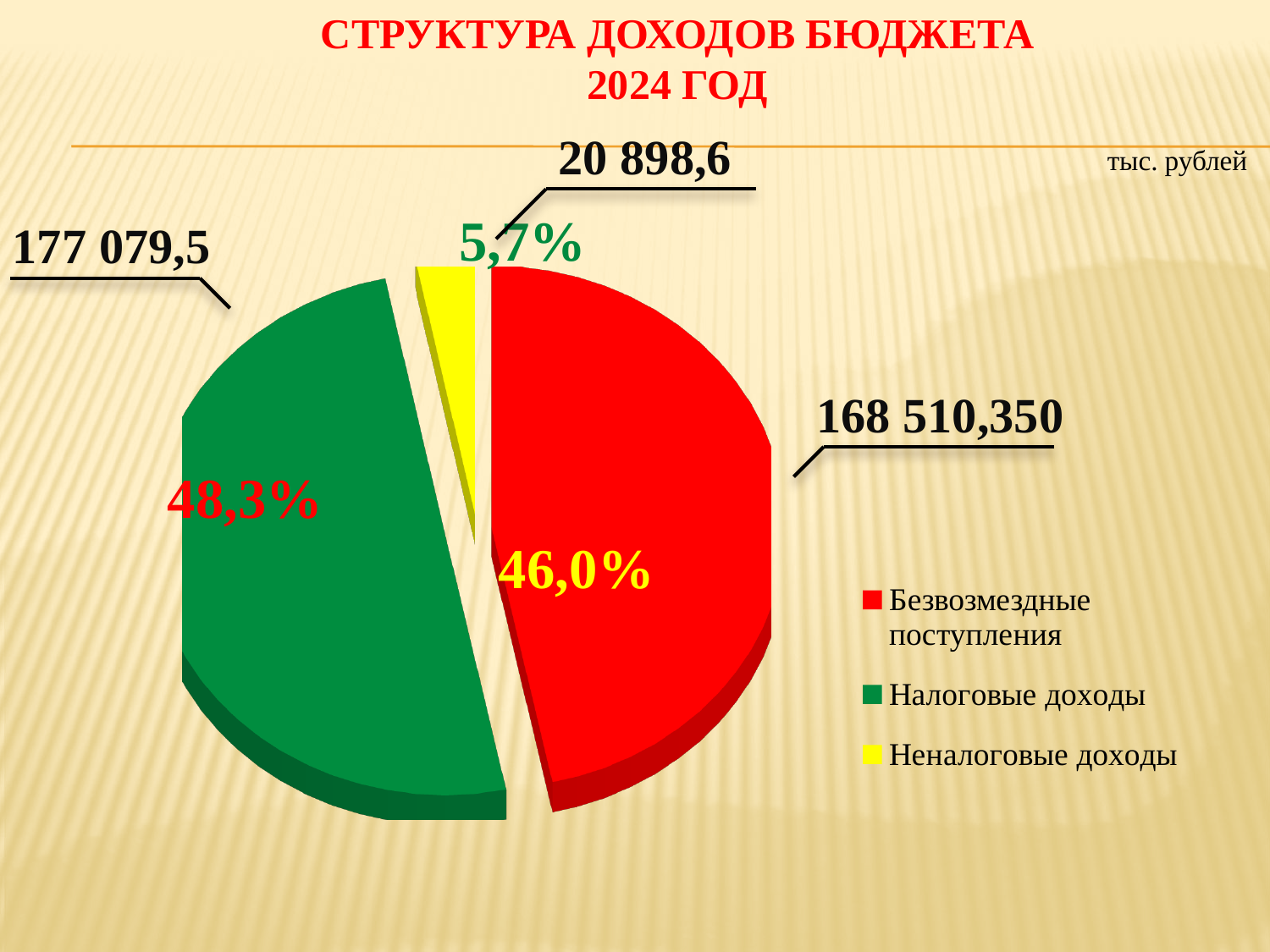
What percentage share does the Безвозмездные поступления slice have? 46,0% What type of chart is shown on the slide? Pie chart What is the value shown for Неналоговые доходы? 20 898,6 Which category has the largest share of the pie? Налоговые доходы Which is larger, the share of Налоговые доходы or the share of Неналоговые доходы? Налоговые доходы How many categories does the pie chart show? 3 What is the difference in percentage points between the Налоговые доходы share and the Неналоговые доходы share? 42,6% Which category has the smallest share of the pie? Неналоговые доходы What is the value shown for Налоговые доходы? 177 079,5 What percentage share does the Налоговые доходы slice have? 48,3% What is the value shown for Безвозмездные поступления? 168 510,350 What percentage share does the Неналоговые доходы slice have? 5,7%